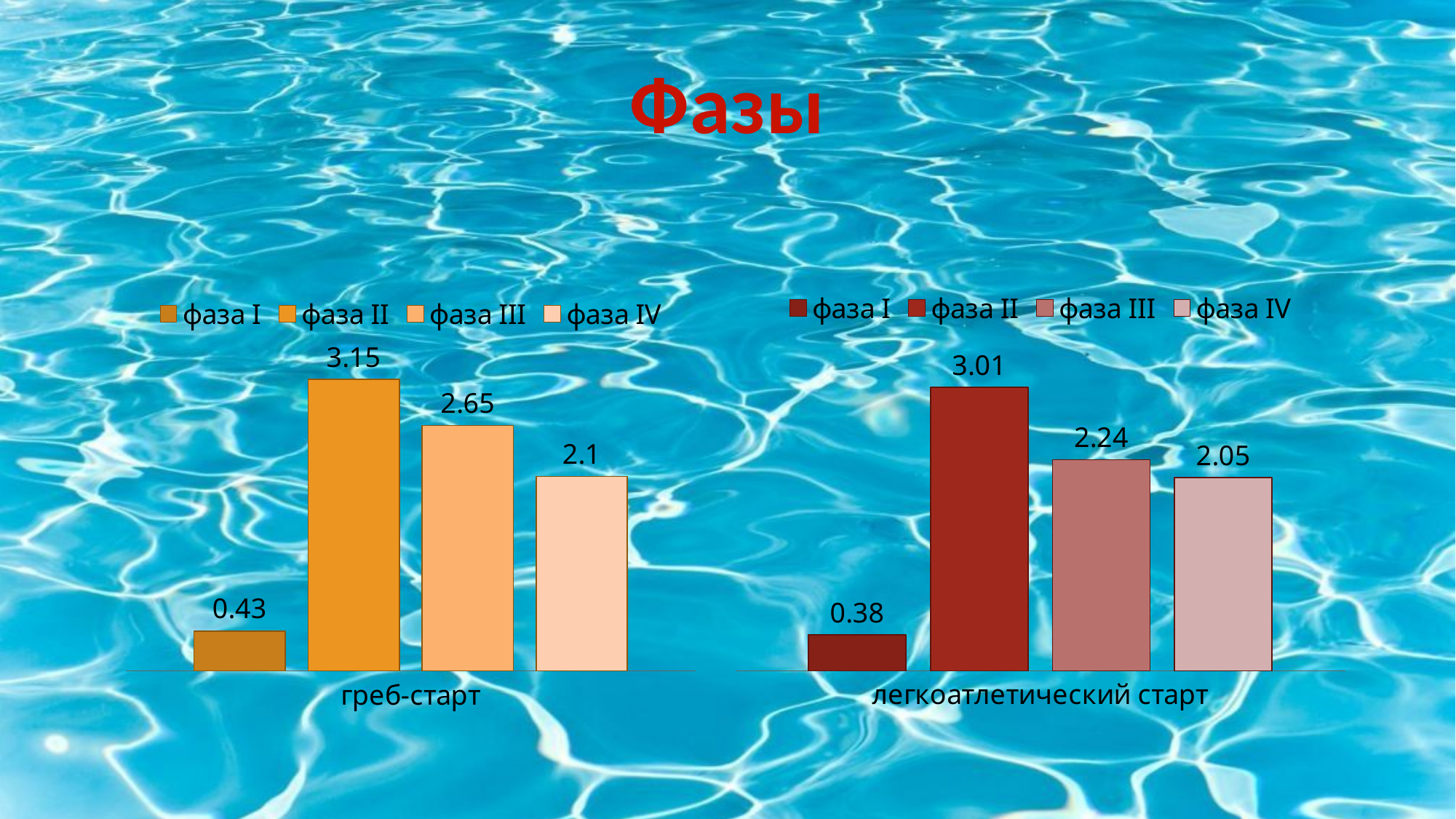
What is the title of the slide? Фазы In the left chart (греб-старт), what is the value for фаза II? 3.15 In the right chart (легкоатлетический старт), what is the value for фаза III? 2.24 In the left chart (греб-старт), which phase has the lowest value? фаза I In the right chart (легкоатлетический старт), which phase has the highest value? фаза II What kind of chart is the left chart (греб-старт)? bar chart In the left chart (греб-старт), what is the value for фаза I? 0.43 Which is larger: фаза IV in the left chart (греб-старт) or фаза IV in the right chart (легкоатлетический старт)? греб-старт In the right chart (легкоатлетический старт), do the values rise or fall from фаза II to фаза IV? fall How many series does the legend of the right chart (легкоатлетический старт) list? 4 In the right chart (легкоатлетический старт), what is the difference between фаза II and фаза I? 2.63 In the left chart (греб-старт), what is the difference between фаза II and фаза III? 0.5